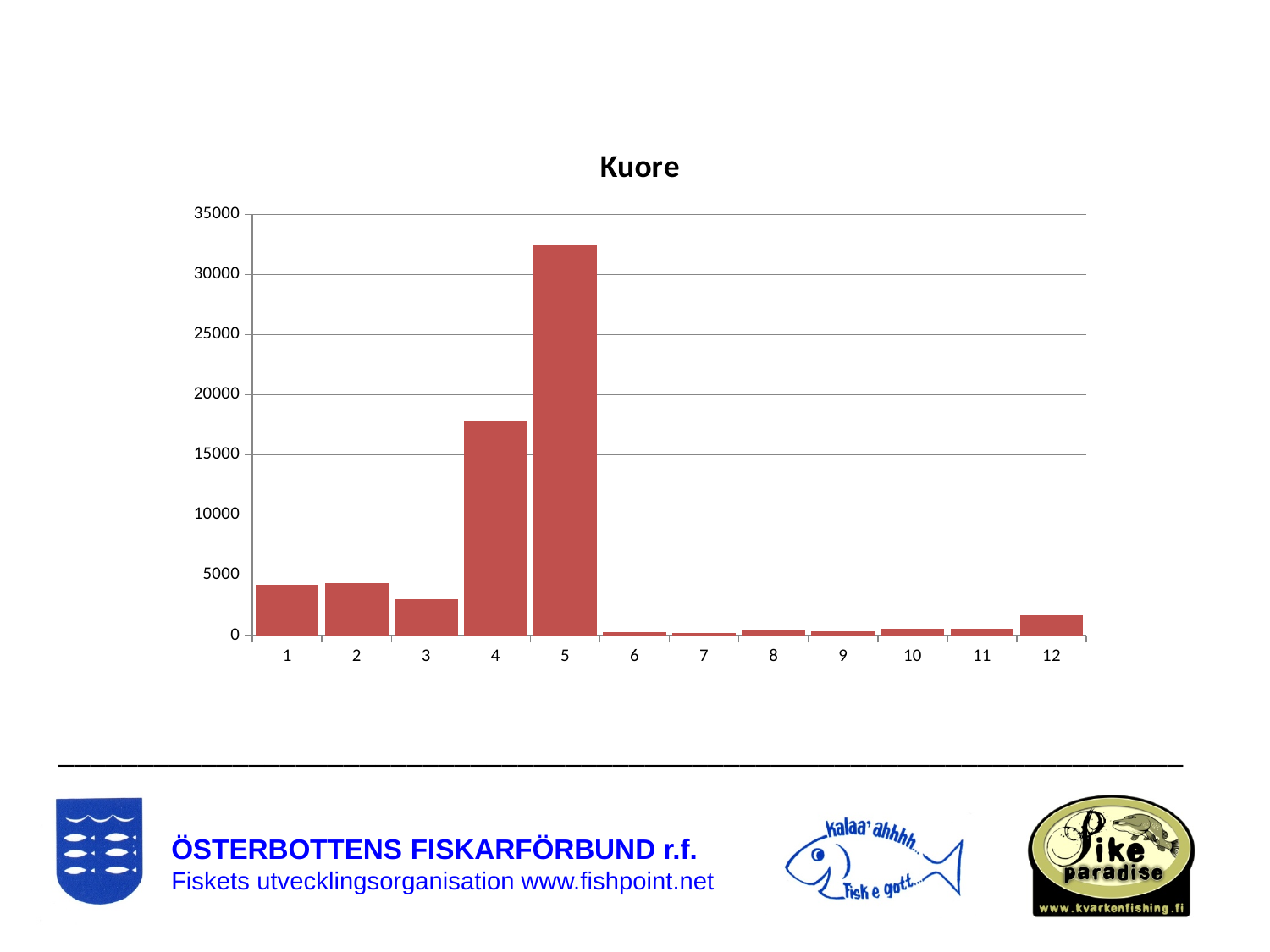
What kind of chart is shown on the slide? bar chart Do the values rise or fall from category 5 to category 6? fall Is the value for category 5 greater or less than 30000? greater Which category has the highest value in the chart? 5 How many categories are shown on the x axis of the chart? 12 Is the value for category 3 greater or less than 5000? less Which has the larger value, category 3 or category 12? 3 Is the value for category 4 greater or less than 20000? less Which has the larger value, category 4 or category 5? 5 What is the title of the chart? Kuore